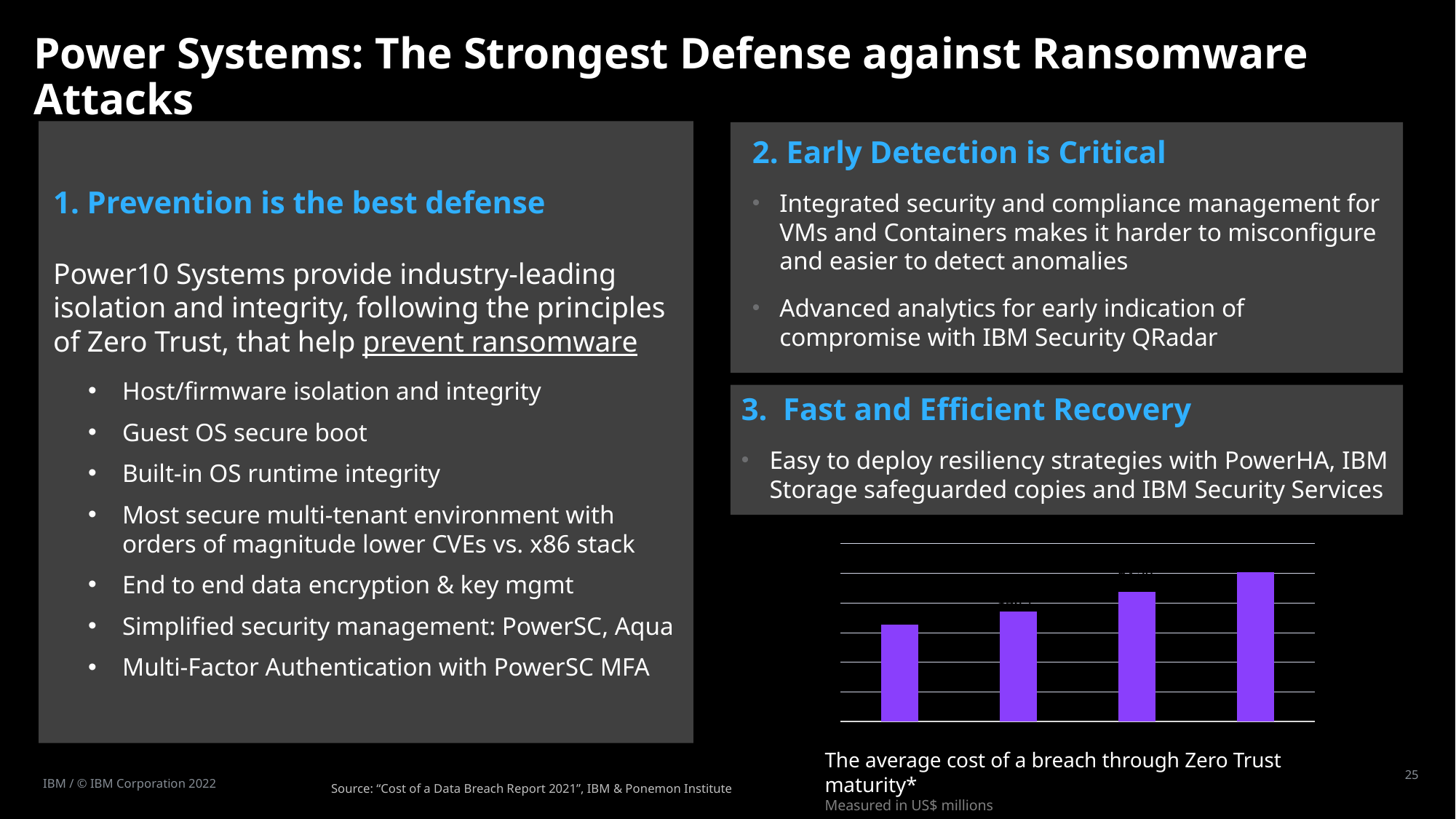
Do the bar values in the chart at the bottom right rise or fall from left to right? rise What colour are the bars in the chart at the bottom right of the slide? purple Which bar in the chart at the bottom right is the tallest, the leftmost or the rightmost? the rightmost According to the caption under the chart, in what unit are the values measured? US$ millions How many bars does the chart at the bottom right of the slide show? 4 Which bar in the chart at the bottom right is the shortest, the leftmost or the rightmost? the leftmost In the chart at the bottom right, is the second bar from the left taller or shorter than the third bar from the left? shorter What kind of chart is shown at the bottom right of the slide? bar chart